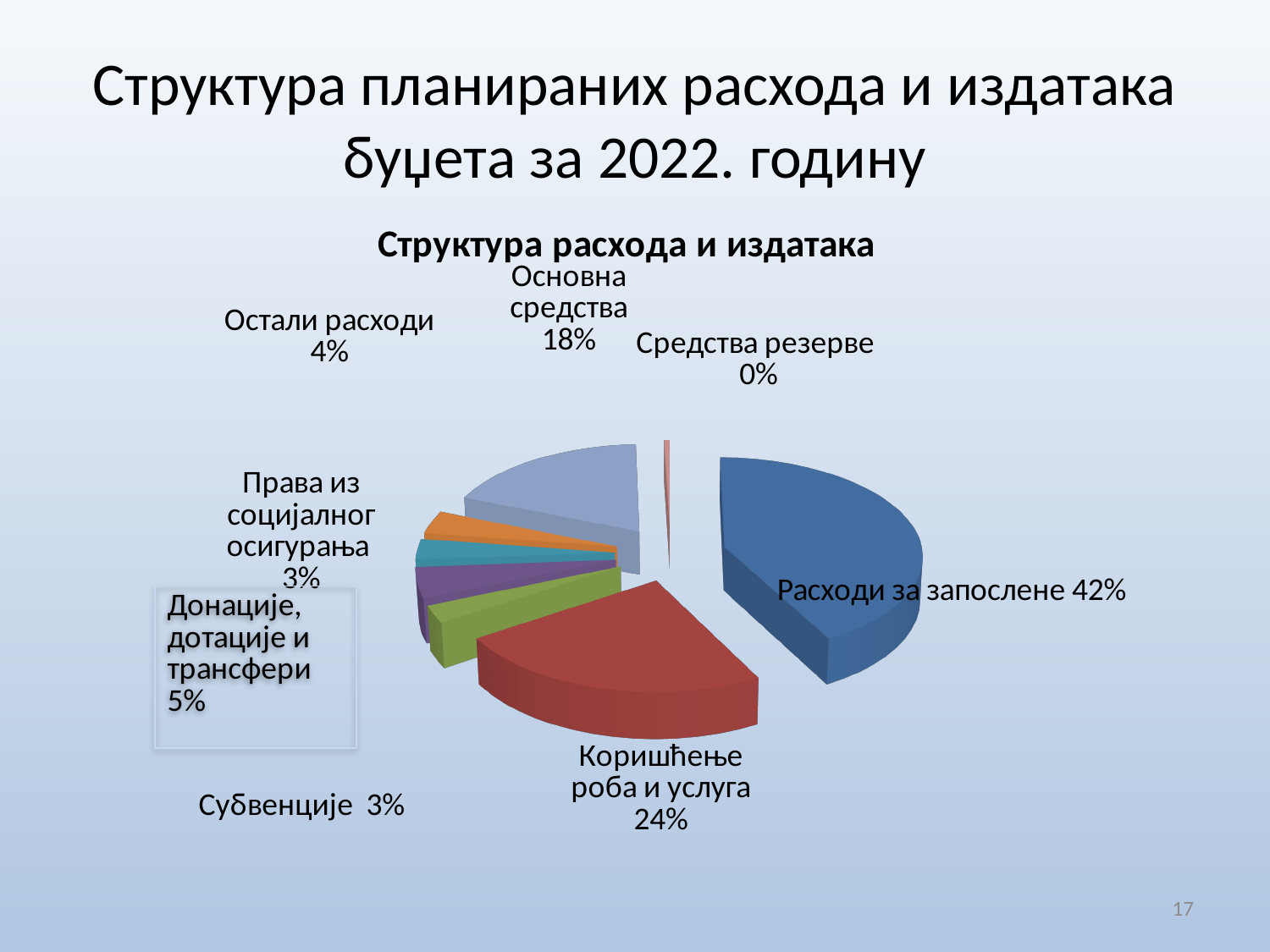
What share of the pie is Средства резерве? 0% Which is larger, the share of Основна средства or the share of Остали расходи? Основна средства What is the difference between the shares of Расходи за запослене and Коришћење роба и услуга? 18% What kind of chart is shown on the slide? pie chart What share of the pie is Коришћење роба и услуга? 24% What share of the pie is Донације, дотације и трансфери? 5% Which category has the largest share of the pie? Расходи за запослене What is the title of the chart? Структура расхода и издатака How many categories are shown in the pie chart? 8 Which category has the smallest share of the pie? Средства резерве What share of the pie is Основна средства? 18% What share of the pie is Расходи за запослене? 42%